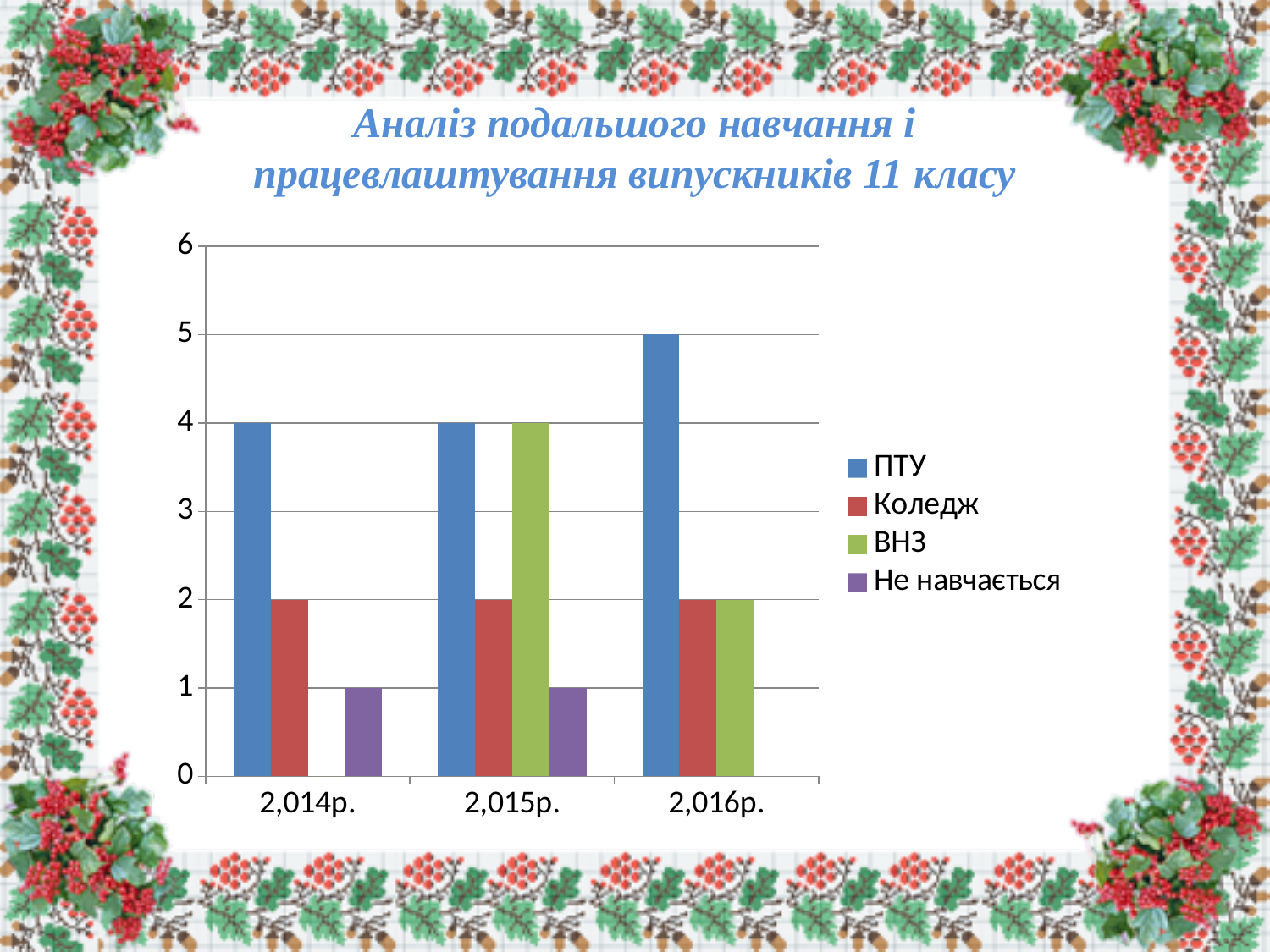
What is the value for Коледж in 2,016р.? 2 What is the difference between the ПТУ value and the Коледж value in 2,016р.? 3 Which is larger in 2,015р., the ВНЗ value or the Коледж value? ВНЗ In which year is the ПТУ value highest? 2,016р. What is the value for Не навчається in 2,014р.? 1 What is the value for ПТУ in 2,016р.? 5 What is the value for ВНЗ in 2,015р.? 4 How many year categories are shown on the x axis? 3 What kind of chart is shown on the slide? Bar chart Which legend entry is shown in purple? Не навчається How many series does the legend list? 4 Does the ПТУ value rise or fall from 2,015р. to 2,016р.? Rise